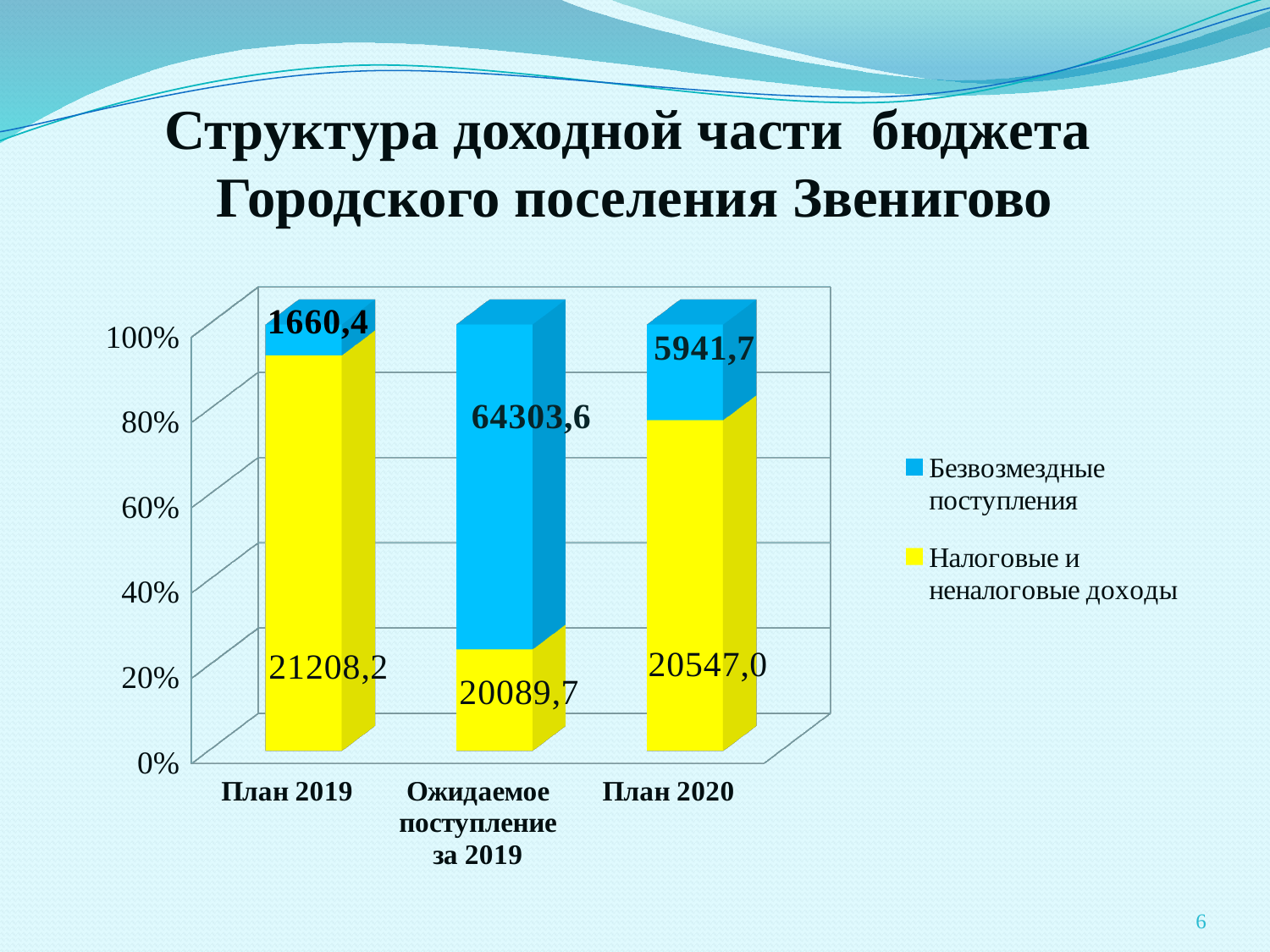
How many categories are shown on the x axis? 3 What is the value of Налоговые и неналоговые доходы for План 2020? 20547,0 What kind of chart is shown on the slide? Stacked bar chart Which category has the highest value for Безвозмездные поступления? Ожидаемое поступление за 2019 Which is larger: Налоговые и неналоговые доходы for План 2019 or for План 2020? План 2019 Which category has the lowest value for Налоговые и неналоговые доходы? Ожидаемое поступление за 2019 What is the value of Налоговые и неналоговые доходы for Ожидаемое поступление за 2019? 20089,7 What is the value of Безвозмездные поступления for План 2019? 1660,4 What is the difference between Безвозмездные поступления for Ожидаемое поступление за 2019 and for План 2020? 58361,9 What is the value of Безвозмездные поступления for План 2020? 5941,7 How many series does the legend list? 2 What is the total of the stacked bar for План 2019? 22868,6